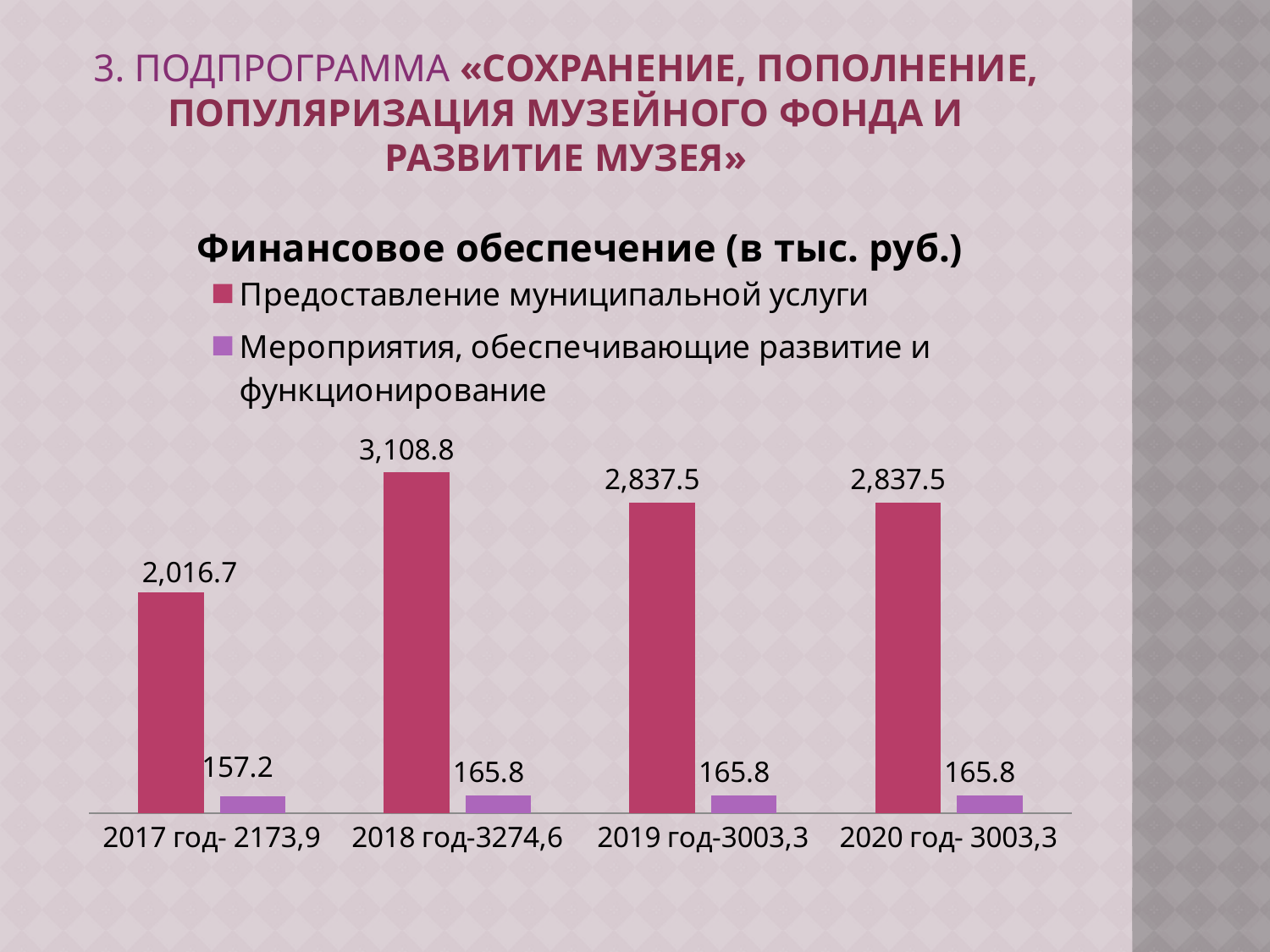
What is the title of the chart? Финансовое обеспечение (в тыс. руб.) What is the value of "Мероприятия, обеспечивающие развитие и функционирование" for 2020 год? 165.8 What is the difference between the "Предоставление муниципальной услуги" values for 2018 год and 2019 год? 271.3 How many year categories are shown on the x axis? 4 In which year is the value of "Предоставление муниципальной услуги" highest? 2018 год What type of chart is shown on the slide? bar chart Which is larger: the "Предоставление муниципальной услуги" value for 2017 год or for 2020 год? 2020 год In which year is the value of "Предоставление муниципальной услуги" lowest? 2017 год What is the value of "Предоставление муниципальной услуги" for 2017 год? 2,016.7 How many series does the chart legend list? 2 What is the value of "Мероприятия, обеспечивающие развитие и функционирование" for 2017 год? 157.2 What is the value of "Предоставление муниципальной услуги" for 2018 год? 3,108.8